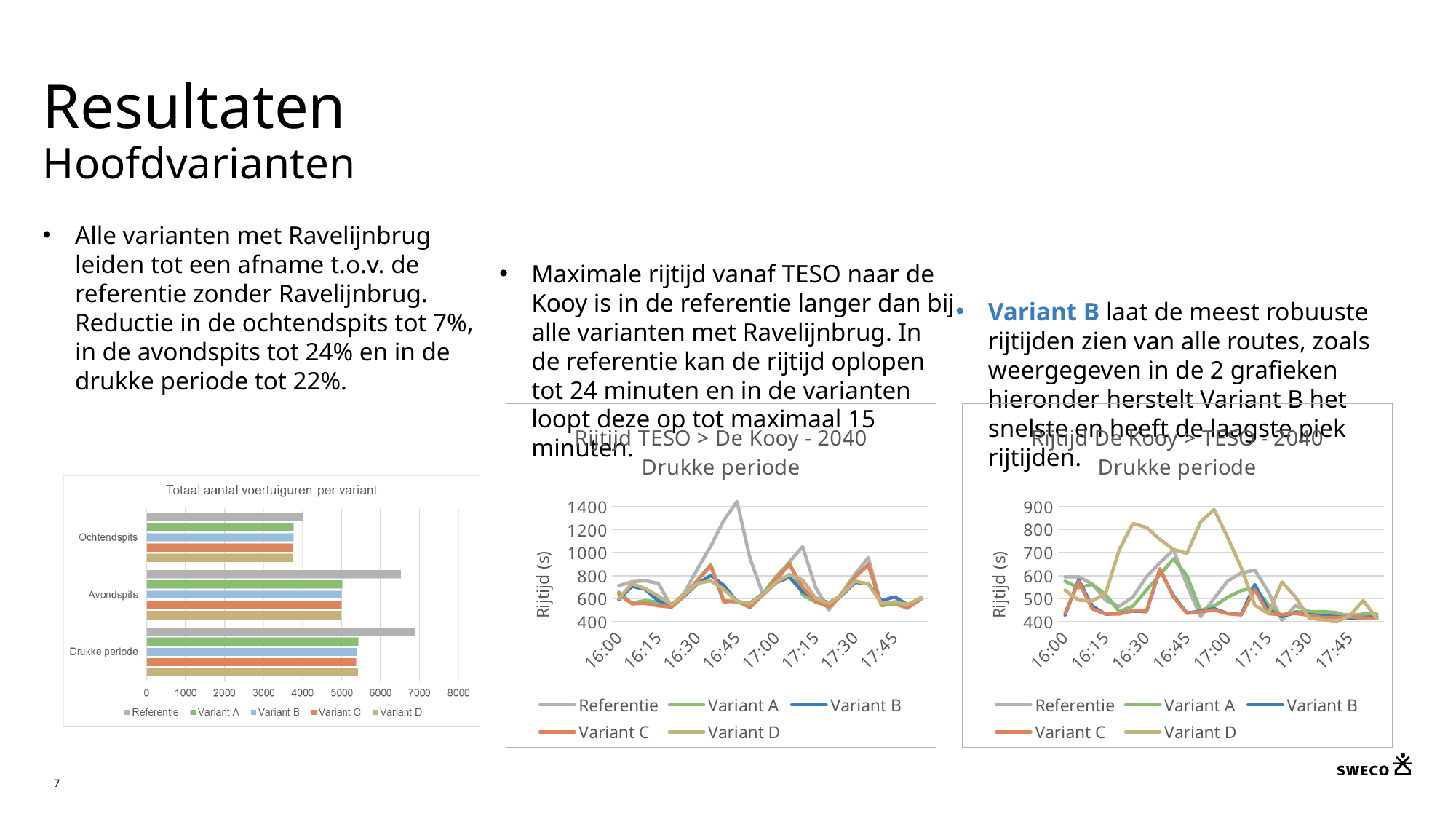
How many categories are shown in the 'Totaal aantal voertuiguren per variant' chart? 3 How many series does the legend of the 'Rijtijd TESO > De Kooy - 2040 Drukke periode' chart list? 5 In the 'Totaal aantal voertuiguren per variant' chart, which is larger for Avondspits: Referentie or Variant A? Referentie In the 'Totaal aantal voertuiguren per variant' chart, is the Referentie value for Drukke periode greater or less than 6000? greater In the 'Rijtijd De Kooy > TESO - 2040 Drukke periode' chart, which series reaches the highest peak? Variant D In the 'Rijtijd TESO > De Kooy - 2040 Drukke periode' chart, which series reaches the highest peak? Referentie What kind of chart is the 'Rijtijd TESO > De Kooy - 2040 Drukke periode' chart? line chart In the 'Rijtijd TESO > De Kooy - 2040 Drukke periode' chart, is the peak value of Referentie around 16:45 greater or less than 1200? greater What kind of chart is the 'Totaal aantal voertuiguren per variant' chart? bar chart How many series does the legend of the 'Totaal aantal voertuiguren per variant' chart list? 5 What is the y-axis label of the 'Rijtijd De Kooy > TESO - 2040 Drukke periode' chart? Rijtijd (s) In the 'Totaal aantal voertuiguren per variant' chart, which series has the highest value for Drukke periode? Referentie